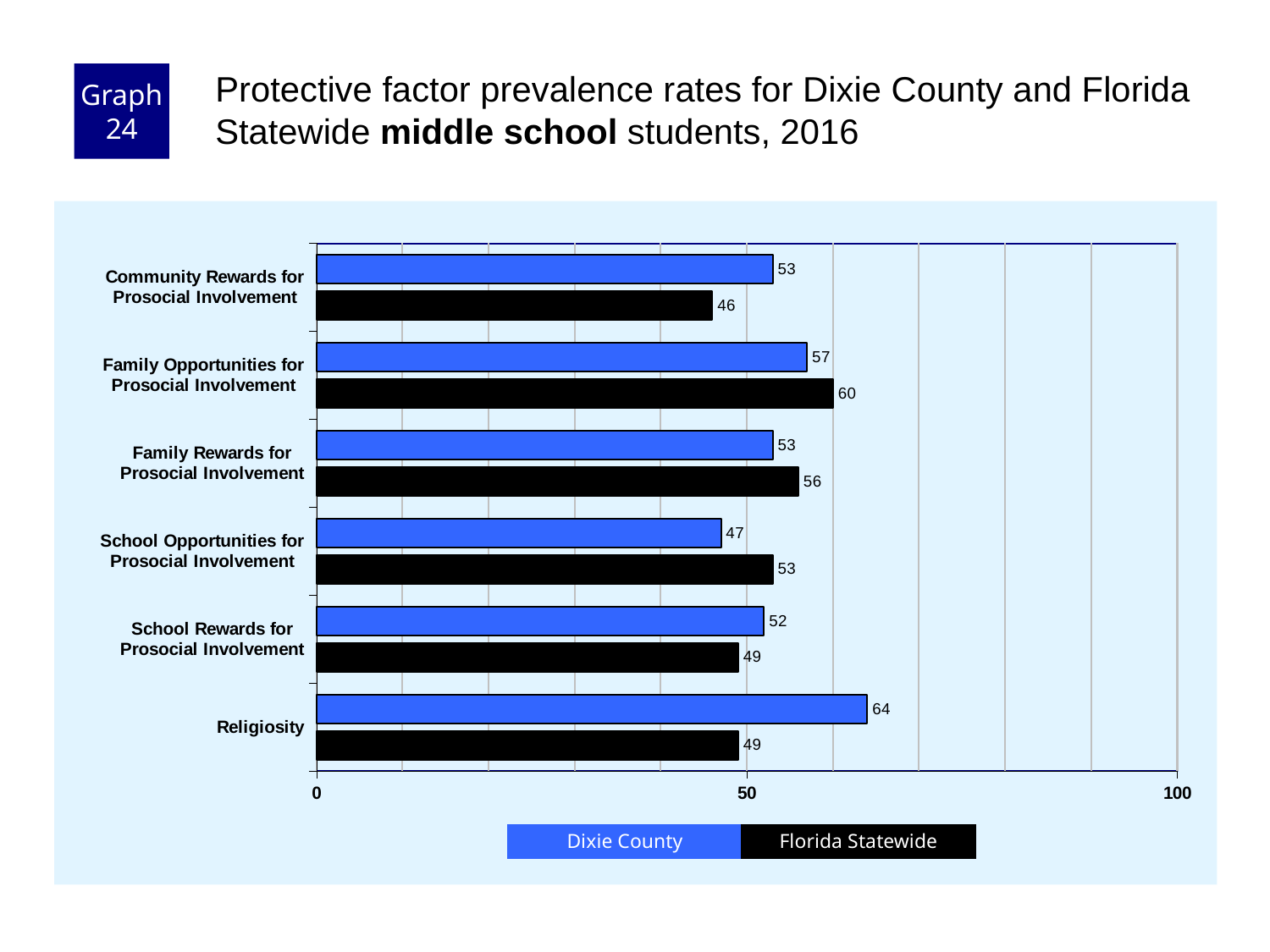
What is the Florida Statewide value for Community Rewards for Prosocial Involvement? 46 Which colour represents Florida Statewide in the chart? Black Which category has the lowest Florida Statewide value? Community Rewards for Prosocial Involvement Which is larger for School Opportunities for Prosocial Involvement: Dixie County or Florida Statewide? Florida Statewide How many series does the legend list? 2 What kind of chart is shown on the slide? Bar chart What is the Dixie County value for Religiosity? 64 What is the Florida Statewide value for Family Opportunities for Prosocial Involvement? 60 How many categories are shown on the chart? 6 What is the difference between the Dixie County and Florida Statewide values for Religiosity? 15 Which category has the highest Dixie County value? Religiosity Is the Dixie County value for Family Opportunities for Prosocial Involvement greater or less than 50? greater